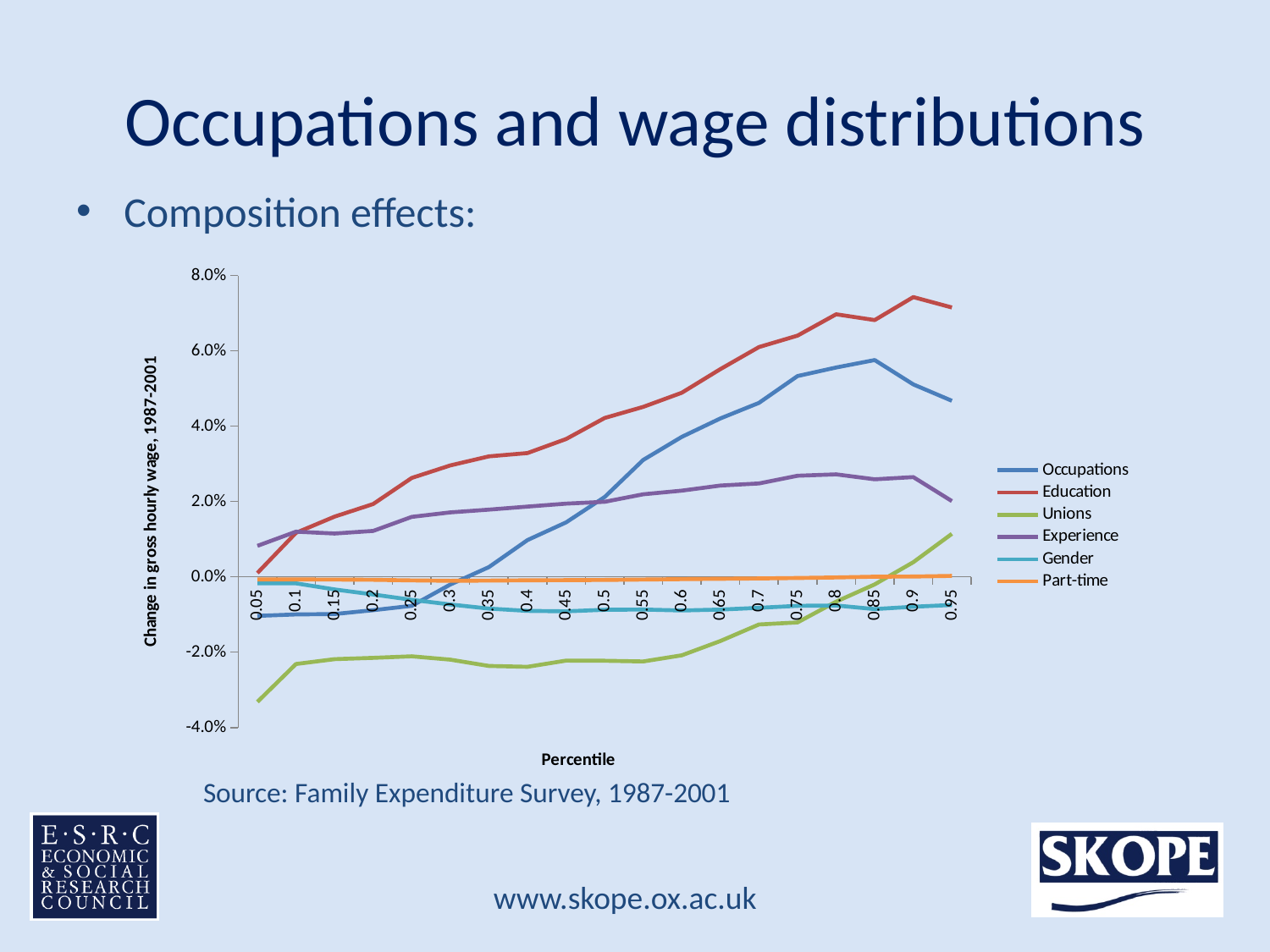
Is the value for Education at the 0.95 percentile greater or less than 6.0%? greater Do the values for Education generally rise or fall as the percentile increases? rise How many series does the legend list? 6 What is the title of the vertical axis? Change in gross hourly wage, 1987-2001 Is the value for Unions at the 0.05 percentile greater or less than -2.0%? less Which series has the highest value at the 0.95 percentile? Education Is the value for Occupations at the 0.85 percentile greater or less than 4.0%? greater At the 0.3 percentile, which is larger: Experience or Occupations? Experience What kind of chart is shown on the slide? line chart How many percentile points are plotted along the x axis? 19 Which series has the lowest value at the 0.05 percentile? Unions At the 0.95 percentile, which is larger: Education or Occupations? Education